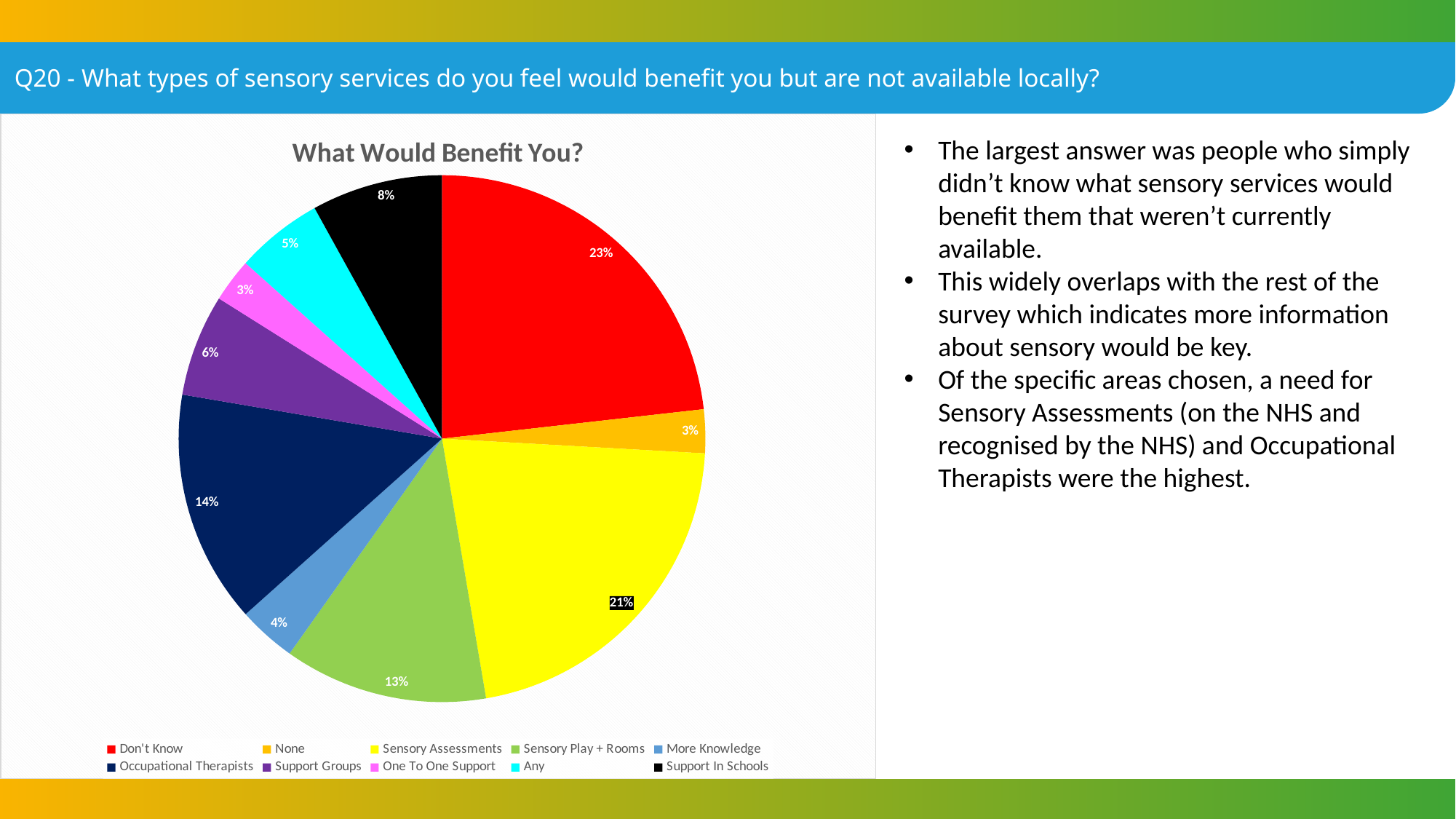
What is the difference in percentage points between Don't Know and Sensory Assessments? 2 What percentage is shown for Occupational Therapists? 14% What percentage is shown for Sensory Play + Rooms? 13% What colour is the slice for Any? Cyan What percentage is shown for Sensory Assessments? 21% What percentage of the pie is labelled for Don't Know? 23% Which is larger, the share for Occupational Therapists or the share for Sensory Play + Rooms? Occupational Therapists What is the title of the chart? What Would Benefit You? What percentage is shown for Support In Schools? 8% What kind of chart is shown on the slide? Pie chart How many categories does the legend list? 10 Which category has the largest share of the pie? Don't Know